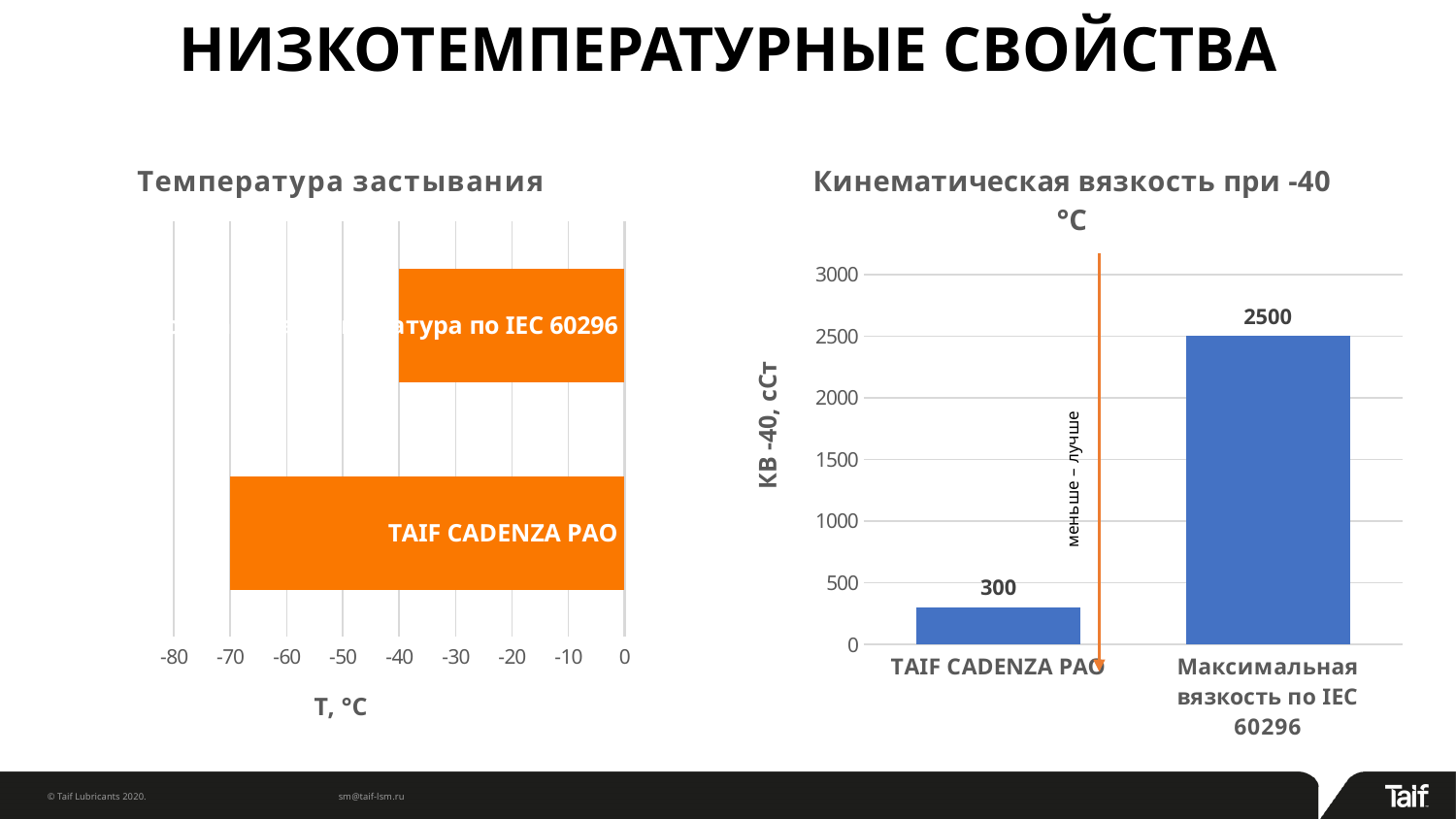
In the chart titled "Температура застывания", what is the difference between the IEC 60296 value and the TAIF CADENZA PAO value? 30 In the chart titled "Кинематическая вязкость при -40 °C", what is the value for TAIF CADENZA PAO? 300 In the chart titled "Температура застывания", what is the x-axis label? T, °C In the chart titled "Температура застывания", what kind of chart is shown? Bar chart In the chart titled "Кинематическая вязкость при -40 °C", what is the difference between Максимальная вязкость по IEC 60296 and TAIF CADENZA PAO? 2200 In the chart titled "Кинематическая вязкость при -40 °C", how many bars are plotted? 2 In the chart titled "Температура застывания", which bar has the lower value? TAIF CADENZA PAO In the chart titled "Температура застывания", what is the value for the IEC 60296 bar? -40 In the chart titled "Температура застывания", what is the value for TAIF CADENZA PAO? -70 In the chart titled "Кинематическая вязкость при -40 °C", what is the y-axis label? КВ -40, сСт In the chart titled "Кинематическая вязкость при -40 °C", which category has the highest value? Максимальная вязкость по IEC 60296 In the chart titled "Кинематическая вязкость при -40 °C", what is the value for Максимальная вязкость по IEC 60296? 2500